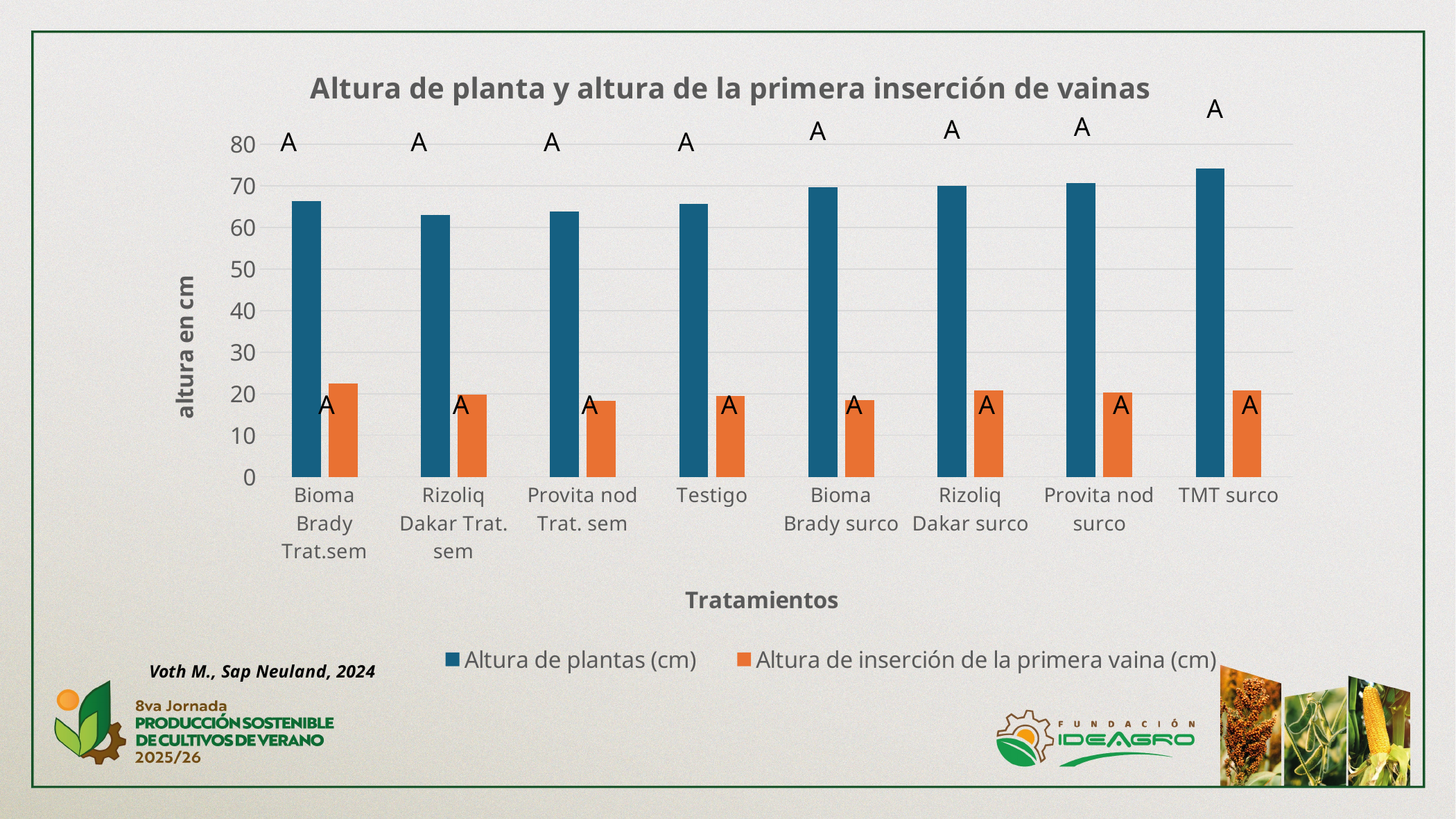
Which treatment has the highest value for Altura de inserción de la primera vaina (cm)? Bioma Brady Trat.sem What kind of chart is shown on the slide? bar chart How many series does the legend list? 2 Is the value of Altura de plantas (cm) for Testigo greater or less than 60? greater How many treatments (categories) are shown on the x axis? 8 Is the value of Altura de inserción de la primera vaina (cm) for Provita nod Trat. sem greater or less than 20? less What is the title of the chart? Altura de planta y altura de la primera inserción de vainas Which treatment has the highest value for Altura de plantas (cm)? TMT surco Which has the larger Altura de plantas (cm): TMT surco or Testigo? TMT surco What is the label of the vertical axis? altura en cm Is the value of Altura de plantas (cm) for TMT surco greater or less than 70? greater